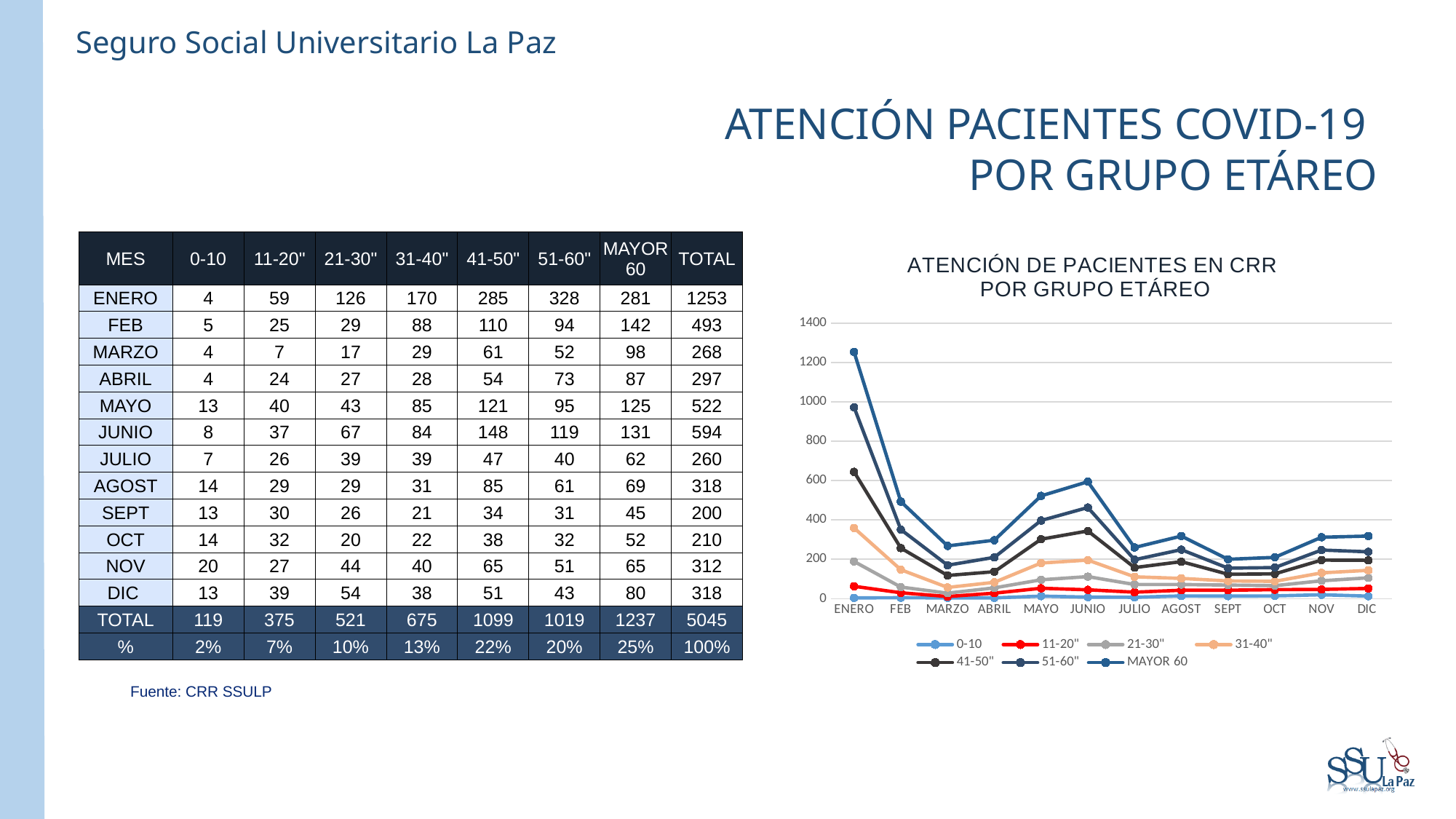
What is the title of the chart? ATENCIÓN DE PACIENTES EN CRR POR GRUPO ETÁREO Is the value of the MAYOR 60 line at ENERO greater or less than 1200? greater How many months are shown along the x axis of the chart? 12 Is the value of the 51-60" line at ENERO greater or less than 800? greater How many series does the legend of the chart list? 7 Does the MAYOR 60 line rise or fall from SEPT to NOV? rise What kind of chart is shown on the slide? line chart For the MAYOR 60 line, which month has the larger value, MAYO or JUNIO? JUNIO Is the value of the MAYOR 60 line at MARZO greater or less than 400? less Does the MAYOR 60 line rise or fall from ENERO to MARZO? fall Which series is plotted lowest on the chart across all months? 0-10 In which month does the MAYOR 60 line reach its highest point? ENERO